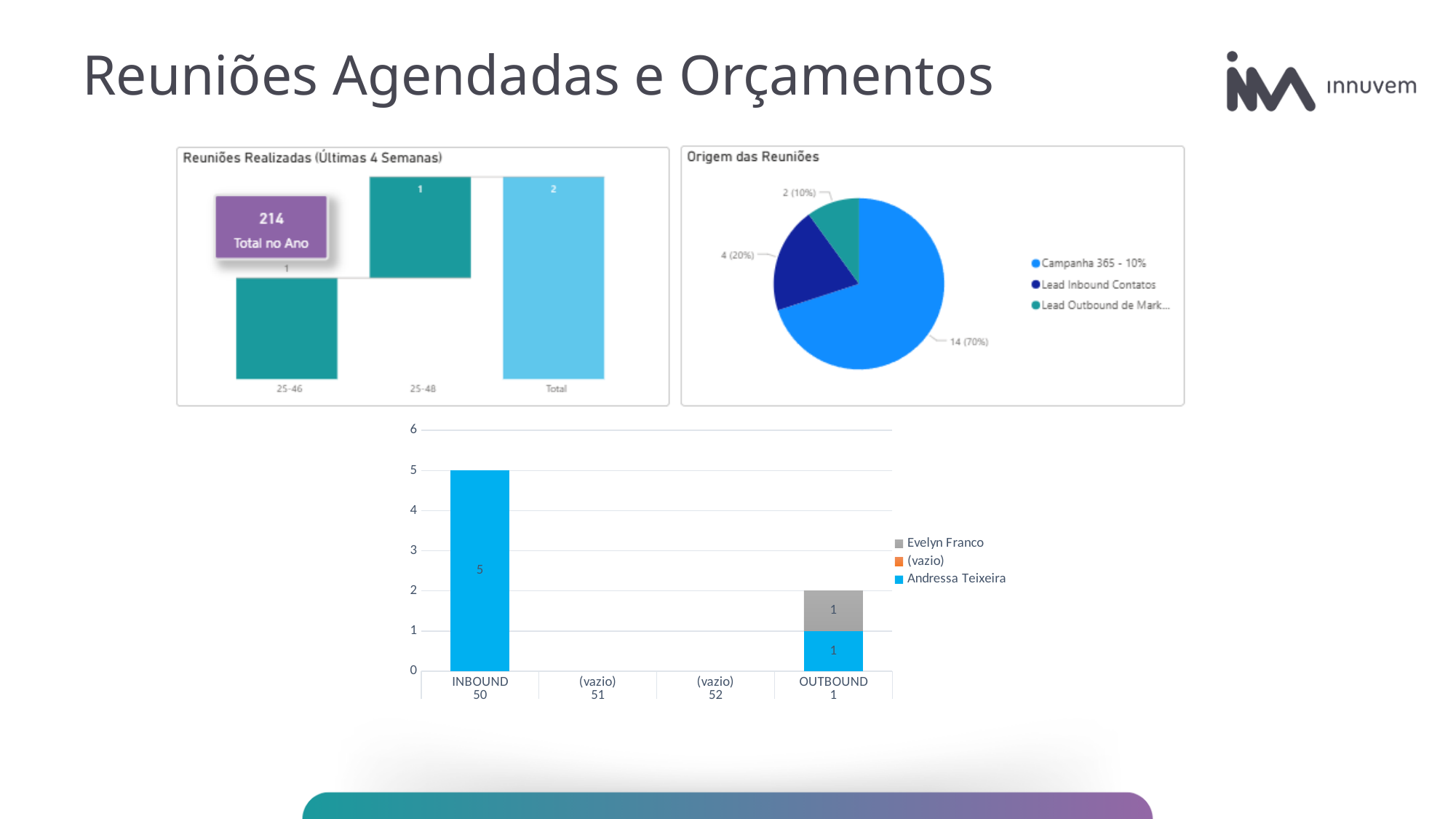
In the bottom bar chart, what is the value for Andressa Teixeira in the 'INBOUND 50' category? 5 In the bottom bar chart, what is the total of the stacked bar for 'OUTBOUND 1'? 2 In the 'Origem das Reuniões' pie chart, what is the difference between the largest slice value and the smallest slice value? 12 In the 'Reuniões Realizadas (Últimas 4 Semanas)' chart, what is the value shown for the 'Total' bar? 2 In the 'Reuniões Realizadas (Últimas 4 Semanas)' chart, what number is shown in the 'Total no Ano' card? 214 What kind of chart is the untitled chart at the bottom of the slide? bar chart In the 'Origem das Reuniões' pie chart, what share of the pie does the 'Lead Inbound Contatos' slice have? 20% In the bottom bar chart, which category has the highest bar? INBOUND 50 How many legend entries does the 'Origem das Reuniões' pie chart list? 3 In the 'Origem das Reuniões' pie chart, which legend entry corresponds to the largest slice? Campanha 365 - 10% In the 'Origem das Reuniões' pie chart, what value and share are shown for the largest slice? 14 (70%) How many series does the legend of the bottom bar chart list? 3